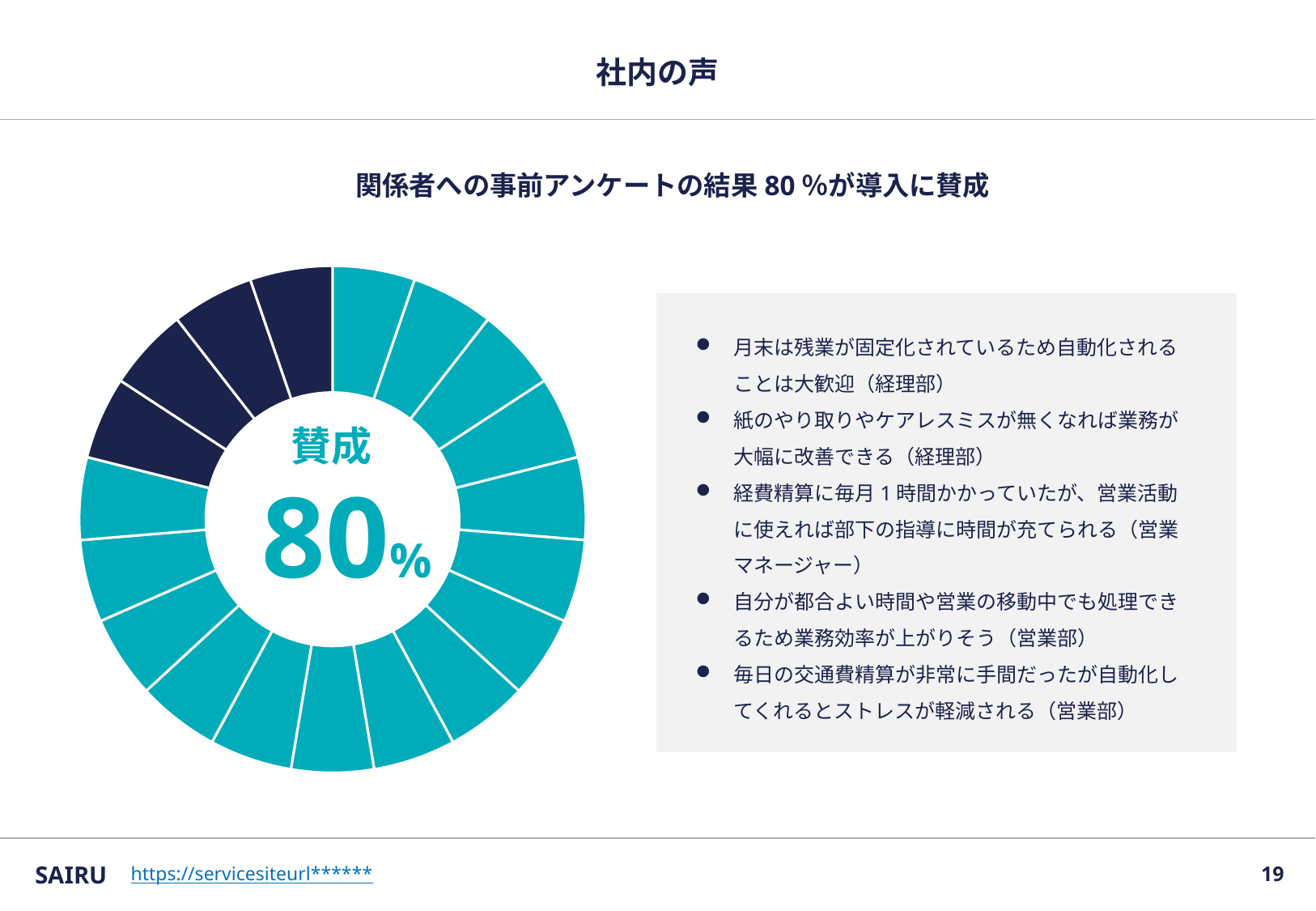
How many segments does the donut chart have in total? 20 What colour are the 賛成 segments in the donut chart? teal What is the heading text above the donut chart? 関係者への事前アンケートの結果 80 %が導入に賛成 What kind of chart is shown on the slide? donut (pie) chart Which is larger in the donut chart: the 賛成 portion or the remaining dark portion? 賛成 What percentage is shown for 賛成 in the donut chart? 80% Does the 賛成 portion of the donut chart account for more or less than half of the whole? more What share of the donut chart does 賛成 represent? 80% How many dark navy segments are there in the donut chart? 4